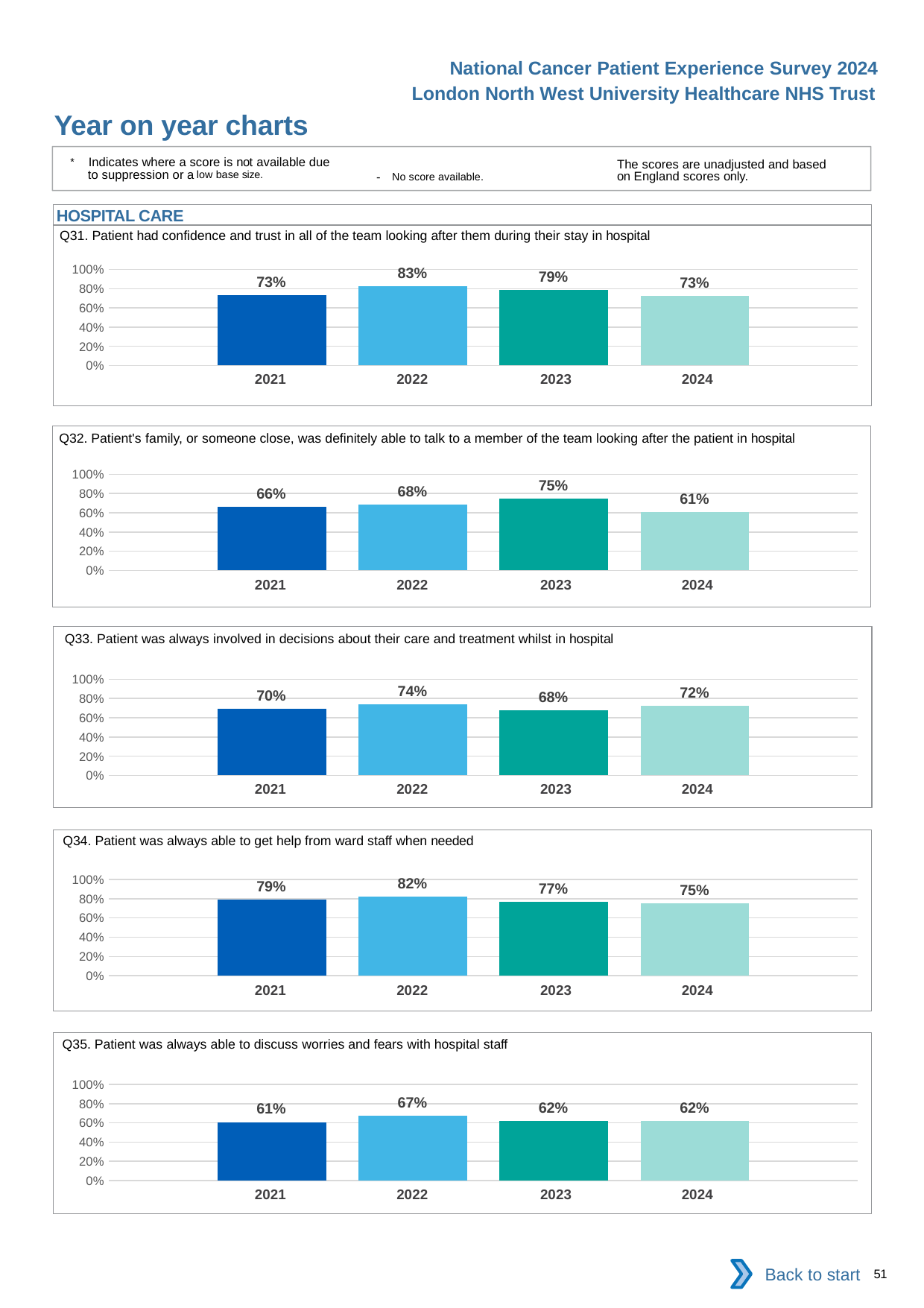
In the Q32 chart, what is the difference between the 2023 and 2024 values? 14 percentage points In the Q31 chart, what is the value for 2022? 83% In the Q33 chart, what is the value for 2023? 68% In the Q32 chart, which year has the lowest value? 2024 How many years are shown on the x axis of the Q31 chart? 4 In the Q31 chart, do the values rise or fall from 2022 to 2024? fall In the Q34 chart, is the value for 2021 or 2024 larger? 2021 In the Q35 chart, what is the value for 2022? 67% In the Q35 chart, is the value for 2021 greater or less than 80%? less What kind of chart is the Q34 chart? bar chart In the Q33 chart, which year has the highest value? 2022 In the Q34 chart, what is the difference between the 2022 and 2023 values? 5 percentage points